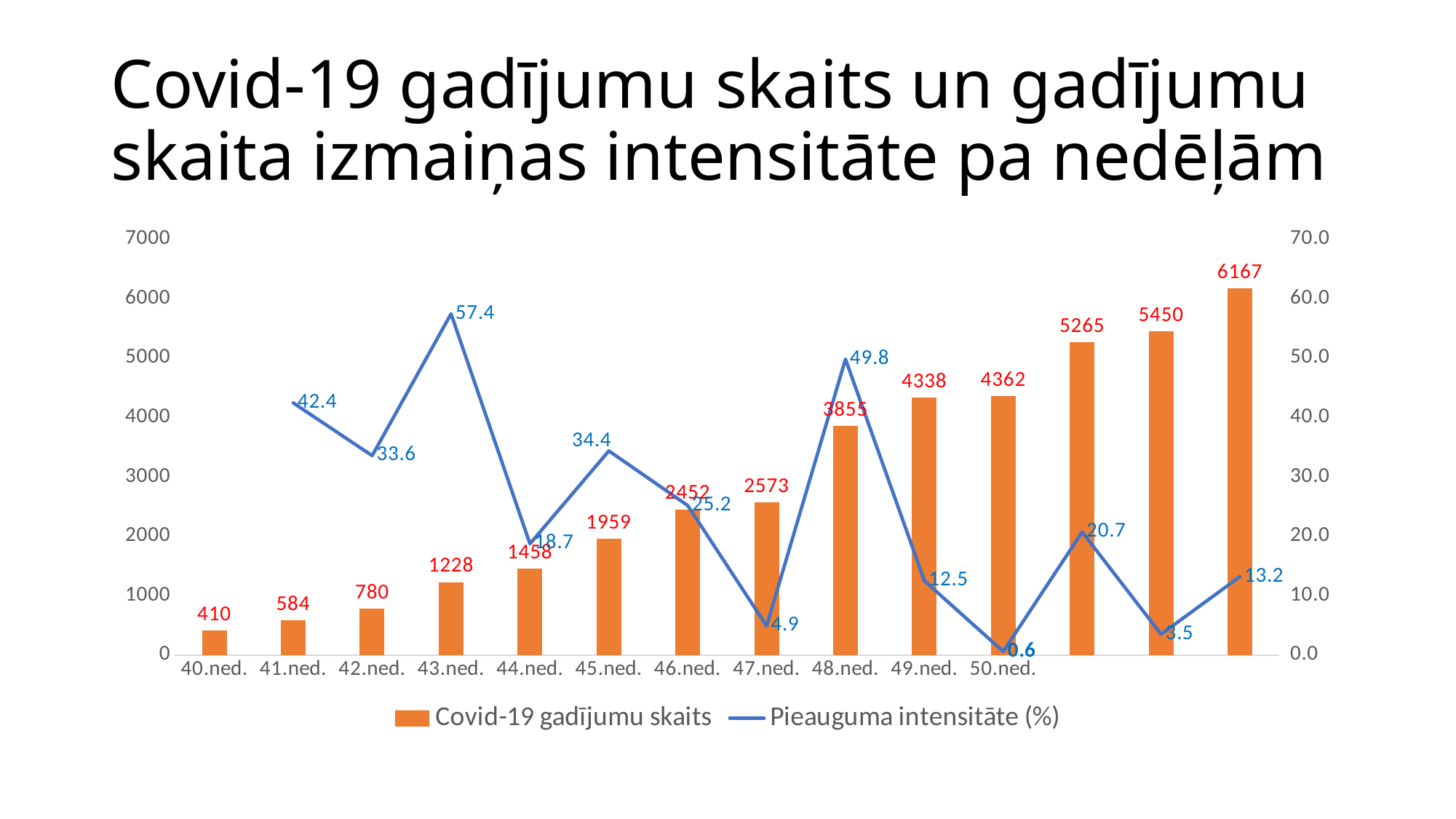
Do the Covid-19 gadījumu skaits values rise or fall from 40.ned. to 50.ned.? rise How many series does the legend list? 2 Which week has the highest Pieauguma intensitāte (%)? 43.ned. What is the Covid-19 gadījumu skaits value for 43.ned.? 1228 What is the Covid-19 gadījumu skaits value for 47.ned.? 2573 Which week has the lowest Pieauguma intensitāte (%)? 50.ned. What is the difference in Covid-19 gadījumu skaits between 48.ned. and 47.ned.? 1282 What is the Pieauguma intensitāte (%) value for 48.ned.? 49.8 Which is larger, the Pieauguma intensitāte (%) for 41.ned. or for 45.ned.? 41.ned. Which week has the lowest Covid-19 gadījumu skaits? 40.ned. What kind of chart is shown on the slide? Combined bar and line chart Is the Covid-19 gadījumu skaits for 49.ned. greater or less than 4000? greater